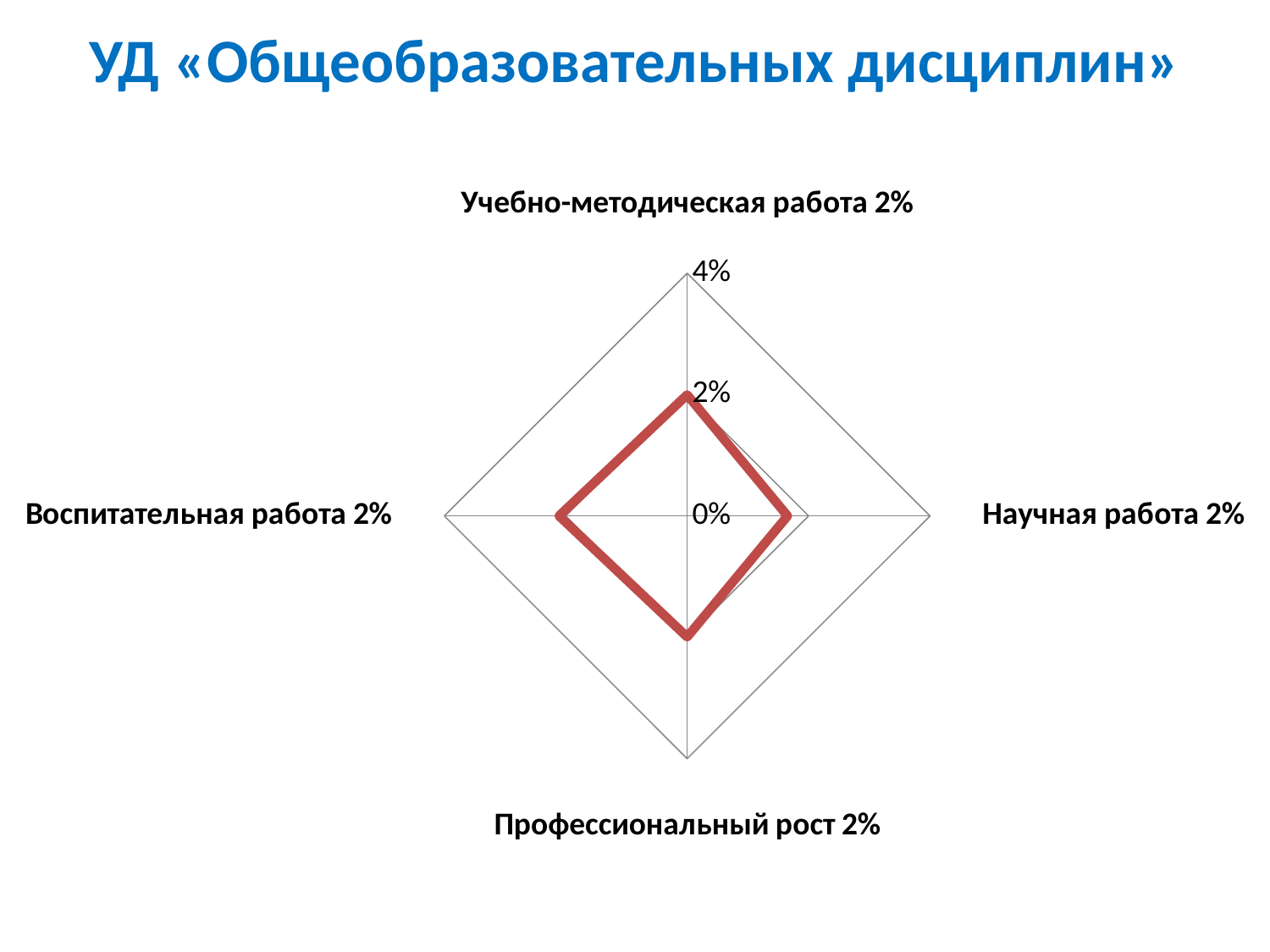
How many categories (axes) does the radar chart have? 4 What is the value for Воспитательная работа? 2% What is the value for Учебно-методическая работа? 2% Is the value for Научная работа greater or less than 4%? less What is the title of the slide containing the chart? УД «Общеобразовательных дисциплин» What is the difference between the values for Учебно-методическая работа and Воспитательная работа? 0% What is the value for Научная работа? 2% What kind of chart is shown on the slide? radar chart What is the value for Профессиональный рост? 2% What is the highest value shown on the radar chart's axis scale? 4%